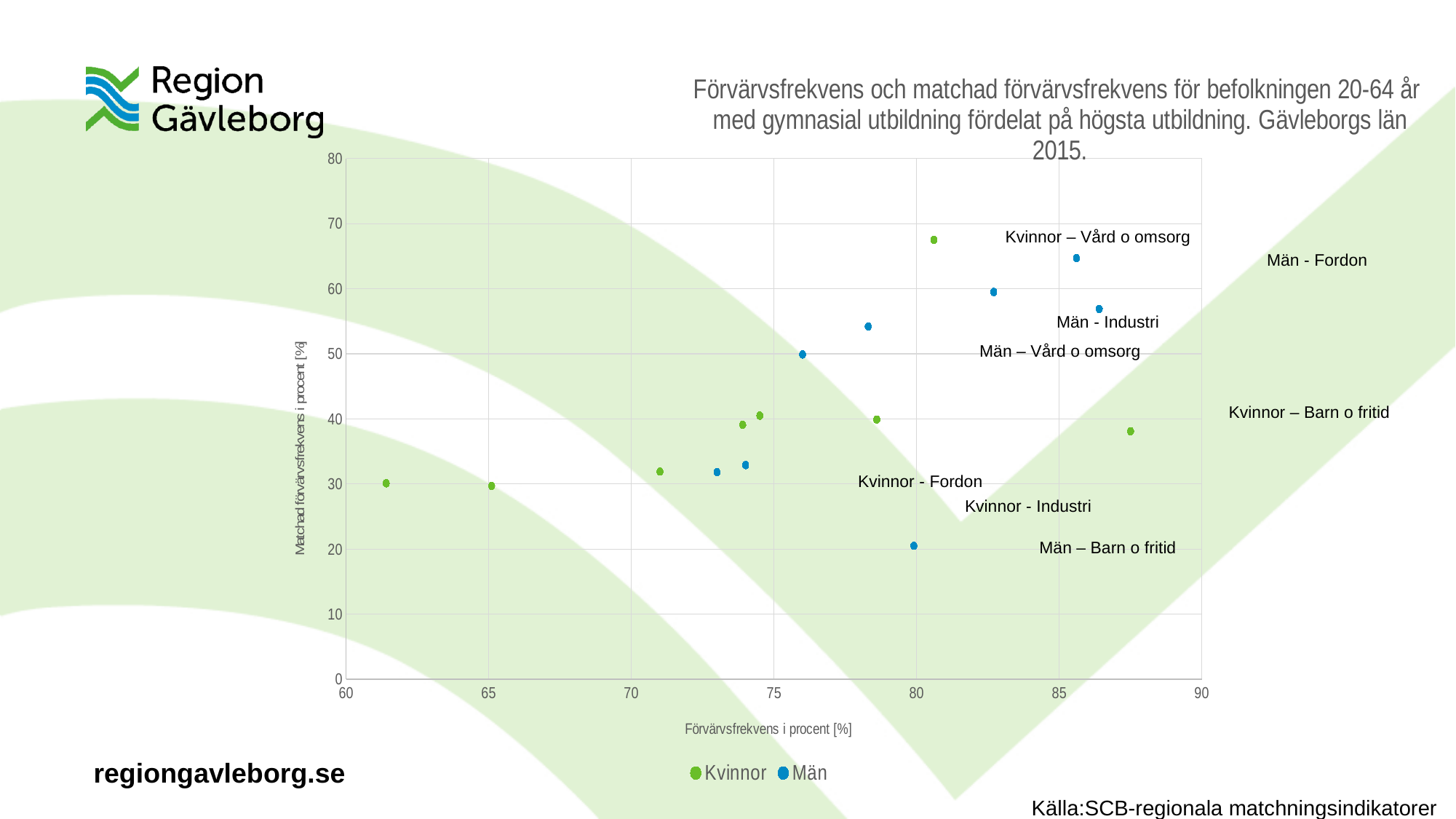
Which series contains the point with the lowest matched employment rate (Matchad förvärvsfrekvens)? Män Which series has the point with the lowest förvärvsfrekvens (leftmost point on the chart)? Kvinnor What is the title of the horizontal axis? Förvärvsfrekvens i procent [%] Is the highest Kvinnor point greater or less than 60 on the vertical axis? greater Is the leftmost Kvinnor point greater or less than 65 on the horizontal axis? less How many series does the legend list? 2 Which series contains the point with the highest matched employment rate (Matchad förvärvsfrekvens)? Kvinnor Which series has the point with the highest förvärvsfrekvens (rightmost point on the chart)? Kvinnor Is the lowest point on the chart (the Män point near 80% förvärvsfrekvens) greater or less than 30 on the vertical axis? less What are the two series named in the legend? Kvinnor and Män What is the maximum value shown on the horizontal axis? 90 What kind of chart is shown on the slide? Scatter chart